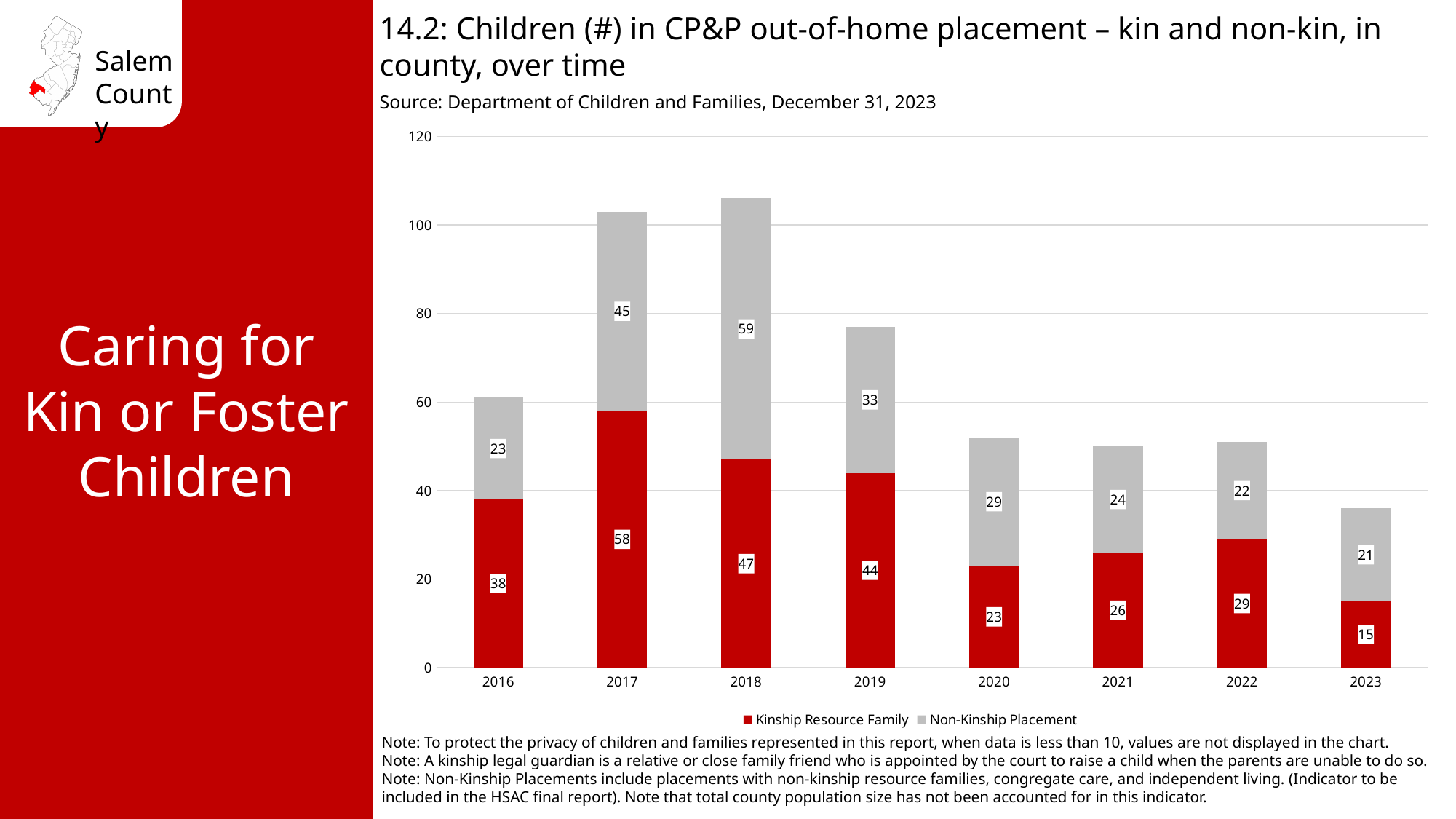
What kind of chart is shown on the slide? Stacked bar chart Is the total height of the 2017 stacked bar greater or less than 100? greater How many years are shown on the x axis? 8 Which is larger in 2018: the Kinship Resource Family value or the Non-Kinship Placement value? Non-Kinship Placement How many series does the legend list? 2 What is the Non-Kinship Placement value for 2018? 59 What is the Kinship Resource Family value for 2023? 15 Which year has the lowest Non-Kinship Placement value? 2023 What is the difference between the Kinship Resource Family value in 2017 and in 2023? 43 Which year has the highest Kinship Resource Family value? 2017 What is the Kinship Resource Family value for 2017? 58 What is the total of the stacked bar for 2016? 61